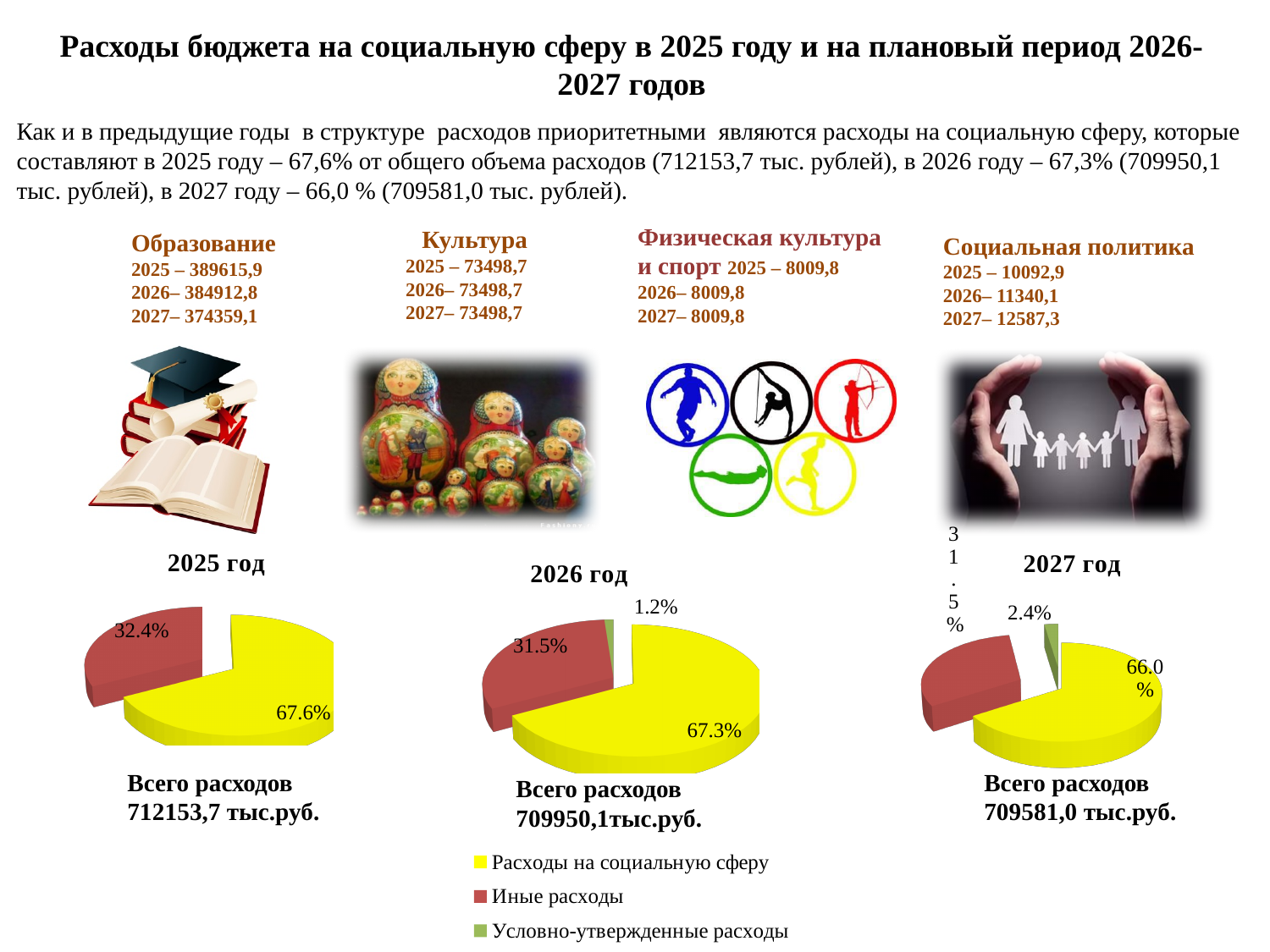
How many slices does the "2025 год" pie chart have? 2 What type of chart is used for "2026 год"? Pie chart In the "2025 год" pie chart, what share is labelled on the red slice (Иные расходы)? 32.4% In the "2026 год" pie chart, which category has the largest slice? Расходы на социальную сферу In the "2027 год" pie chart, which category has the smallest slice? Условно-утвержденные расходы In the "2025 год" pie chart, what is the difference between the shares of Расходы на социальную сферу and Иные расходы? 35.2% In the "2026 год" pie chart, what share is labelled for Условно-утвержденные расходы? 1.2% In the "2025 год" pie chart, what share is labelled on the yellow slice (Расходы на социальную сферу)? 67.6% In the "2027 год" pie chart, what share is labelled for Расходы на социальную сферу? 66.0% How many entries does the shared legend below the pie charts list? 3 In the "2027 год" pie chart, what share is labelled for Условно-утвержденные расходы? 2.4% In the "2026 год" pie chart, what share is labelled for Иные расходы? 31.5%